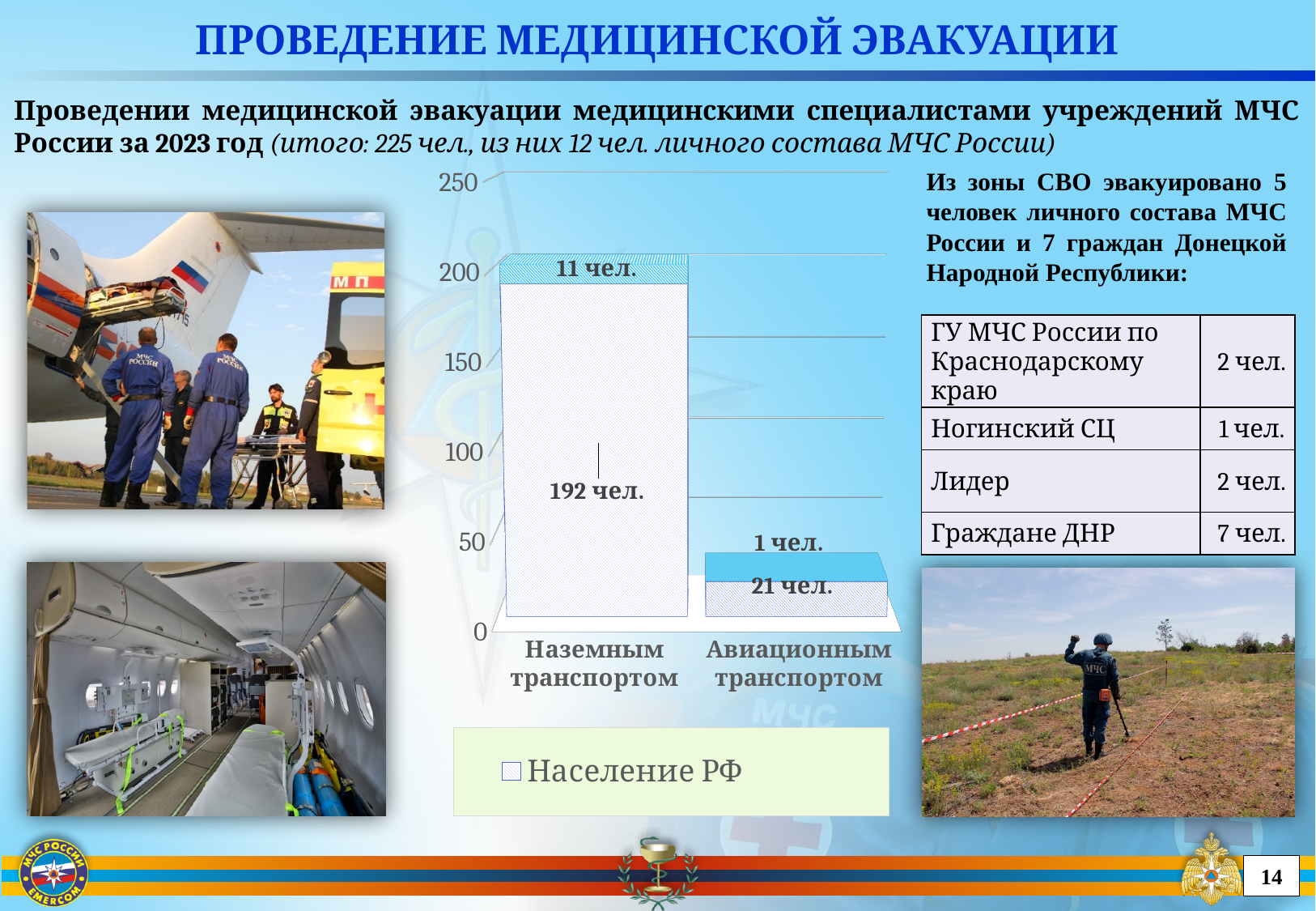
What is the value of the "Население РФ" segment for "Авиационным транспортом"? 21 чел. What is the total of the stacked bar for "Авиационным транспортом"? 22 чел. Is the total value for "Авиационным транспортом" greater or less than 50? less What entry does the chart legend list? Население РФ What is the total of the stacked bar for "Наземным транспортом"? 203 чел. Which category has the higher total bar? Наземным транспортом What value is printed on the upper segment of the "Наземным транспортом" bar? 11 чел. What value is printed on the upper segment of the "Авиационным транспортом" bar? 1 чел. What is the difference between the "Население РФ" values for "Наземным транспортом" and "Авиационным транспортом"? 171 чел. How many categories are shown on the x axis of the chart? 2 What kind of chart is shown on the slide? bar chart What is the value of the "Население РФ" segment for "Наземным транспортом"? 192 чел.